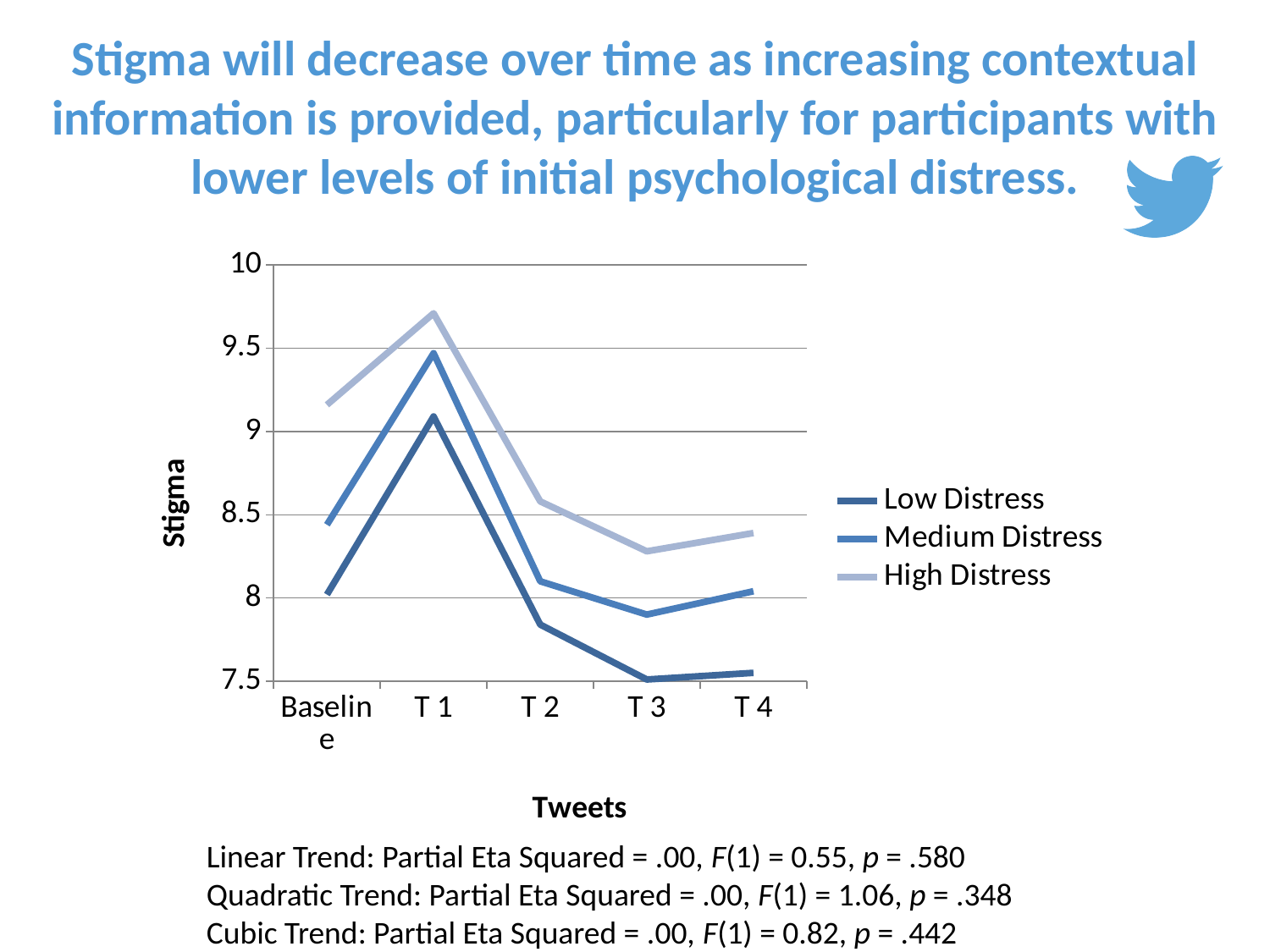
What is the title of the y axis? Stigma Is the Medium Distress value at T 1 greater or less than 9? greater Which series has the highest stigma value at Baseline? High Distress At which time point does the High Distress line reach its highest value? T 1 At which time point does the Low Distress line reach its lowest value? T 3 What kind of chart is shown on the slide? Line chart At T 3, which series has the higher stigma value, Medium Distress or High Distress? High Distress Is the High Distress value at Baseline greater or less than 9? greater Is the Low Distress value at T 2 greater or less than 8? less How many series does the legend list? 3 From T 1 to T 3, does the Low Distress line rise or fall? Fall How many time points are plotted along the x axis? 5